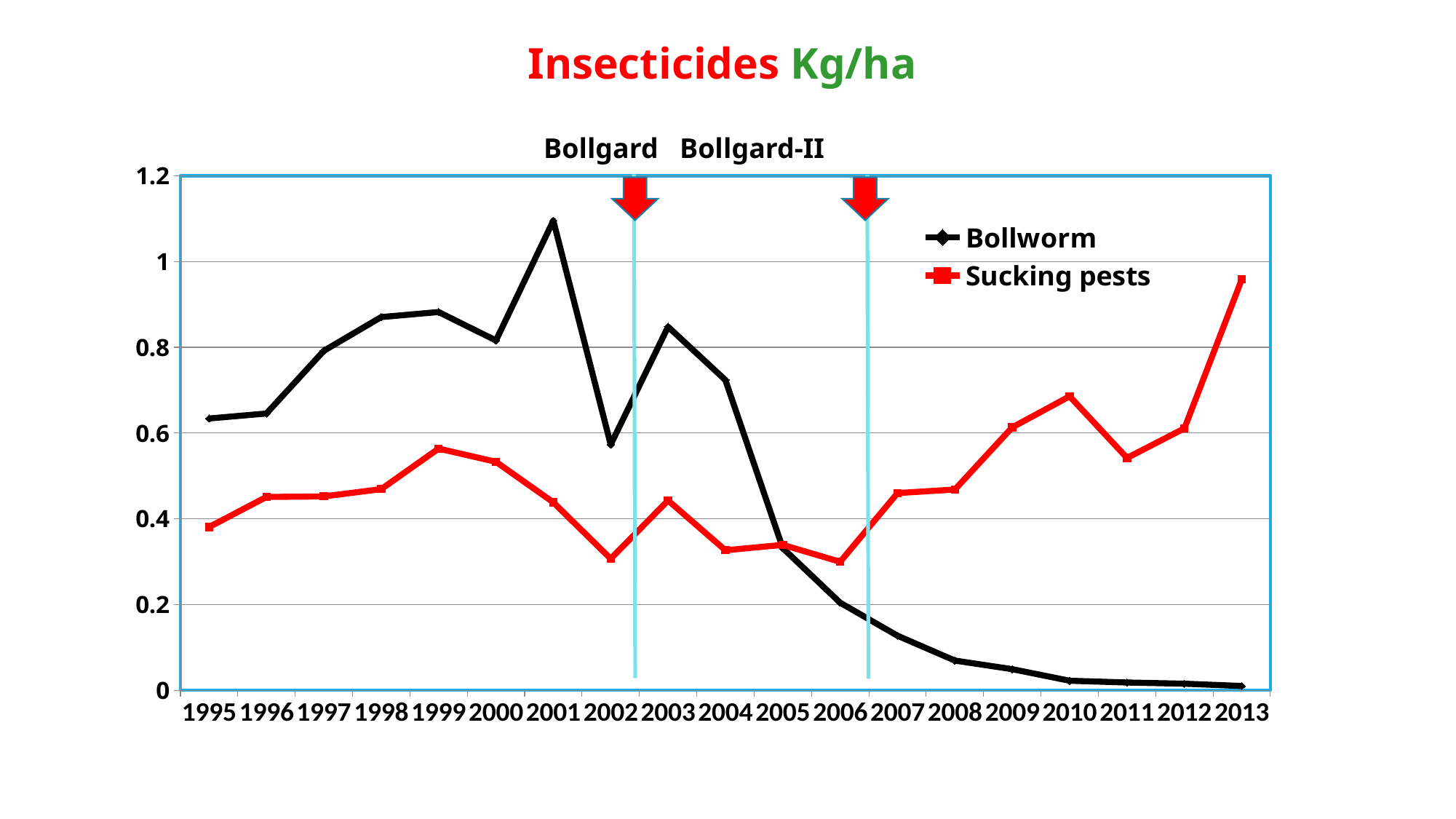
In which year is the Sucking pests value highest? 2013 Is the Sucking pests value for 2013 greater or less than 0.8? greater What kind of chart is shown on the slide? line chart How many series does the legend list? 2 Does the Bollworm line rise or fall from 2004 to 2013? fall Is the Bollworm value for 2010 greater or less than 0.2? less In which year is the Bollworm value highest? 2001 Is the Bollworm value for 2001 greater or less than 1? greater What is the title of the chart? Insecticides Kg/ha In 2013, which series has the larger value, Bollworm or Sucking pests? Sucking pests In 1995, which series has the larger value, Bollworm or Sucking pests? Bollworm How many years are plotted along the x axis? 19